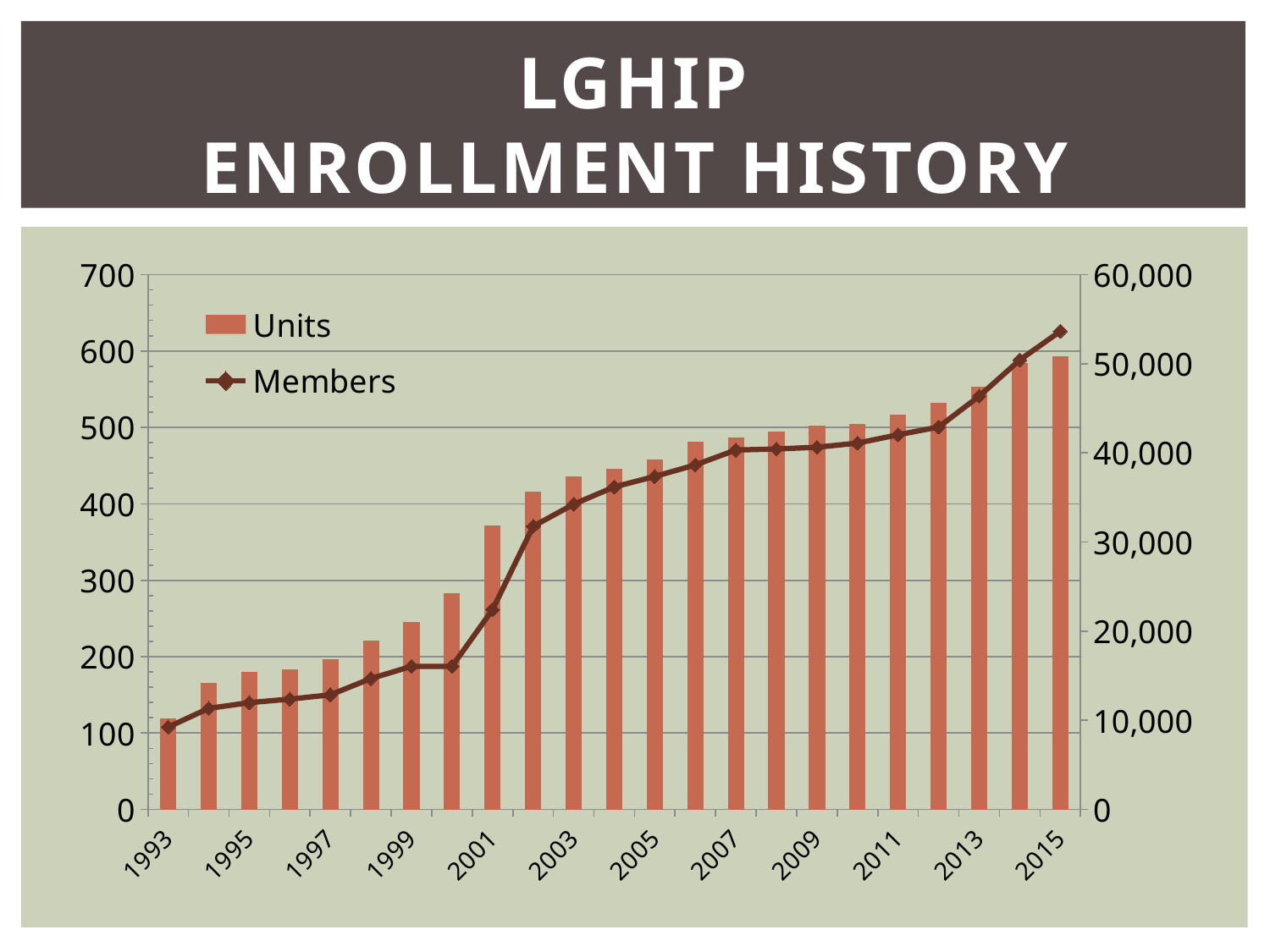
What kind of chart is shown on the slide? A combined bar and line chart Is the value for Members in 2001 greater or less than 20,000? greater How many series does the legend list? 2 Which two series are listed in the legend? Units and Members Which year has the larger value for Units, 1995 or 2005? 2005 Which year has the lowest value for Units? 1993 How many years are plotted along the x axis? 23 Is the value for Members in 2015 greater or less than 50,000? greater Which year has the highest value for Units? 2015 Is the value for Units in 2000 greater or less than 300? less Do the Members values generally rise or fall from 1993 to 2015? Rise